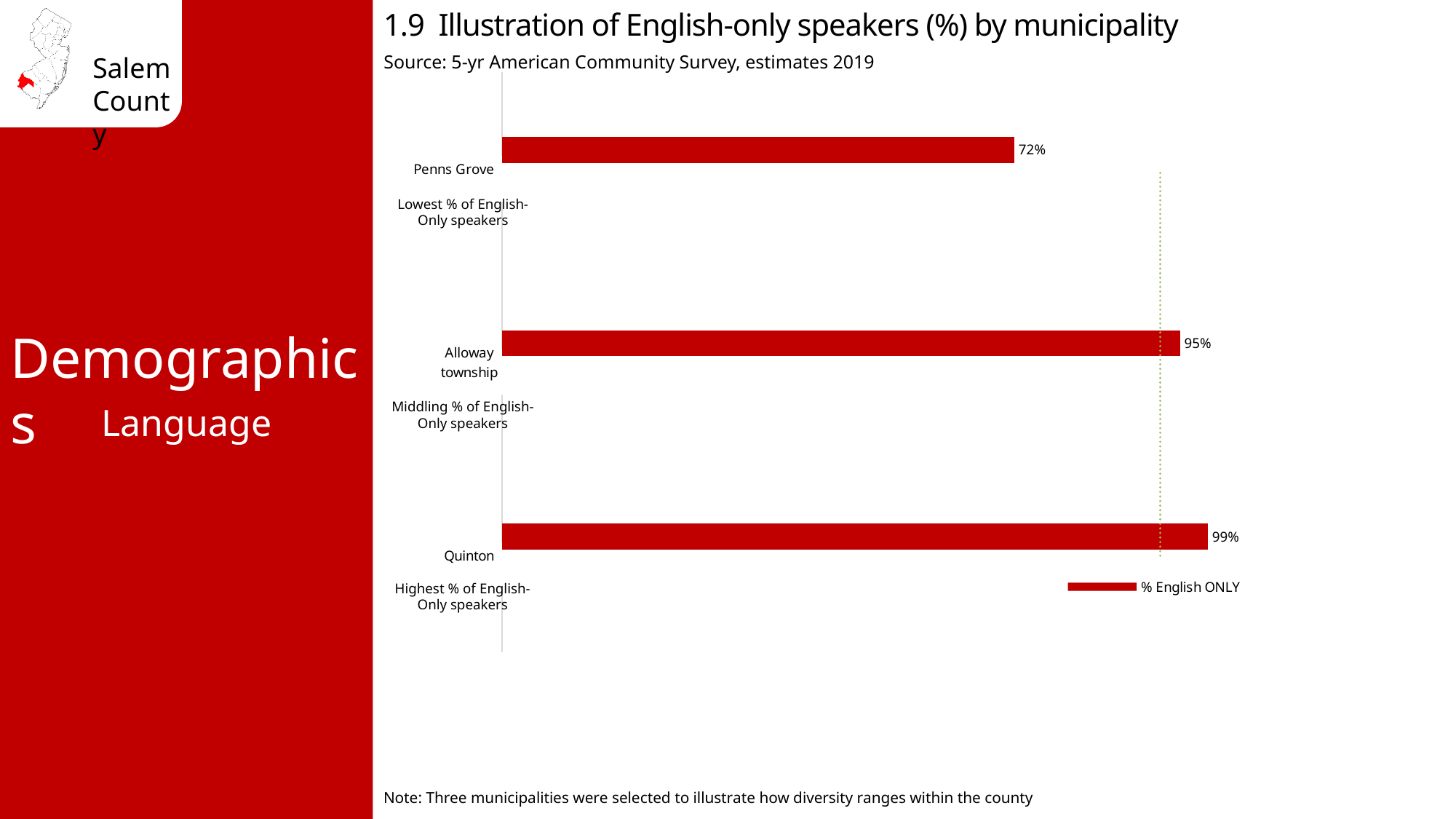
How many series does the legend list? 1 What is the difference in percentage points between Alloway township and Penns Grove? 23 What is the percentage of English-only speakers in Alloway township? 95% What is the percentage of English-only speakers in Quinton? 99% Which municipality has the highest percentage of English-only speakers? Quinton Which has a higher percentage of English-only speakers, Alloway township or Penns Grove? Alloway township What kind of chart is shown on the slide? Bar chart Which municipality has the lowest percentage of English-only speakers? Penns Grove How many municipalities are shown in the chart? 3 What is the legend entry for the series shown in the chart? % English ONLY What is the difference in percentage points between Quinton and Penns Grove? 27 What is the percentage of English-only speakers in Penns Grove? 72%